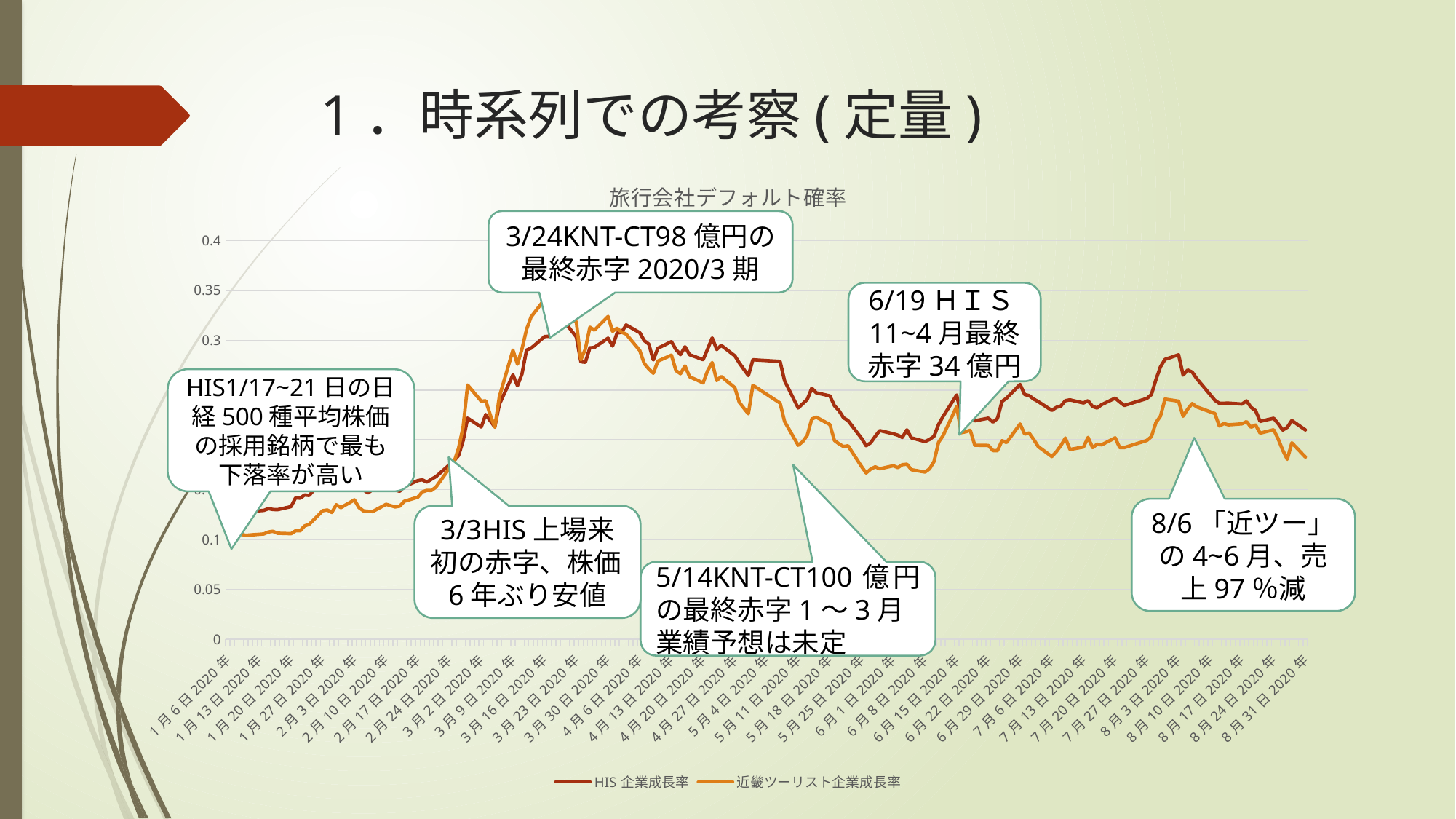
At 3月16日2020年, which series has the higher value, HIS 企業成長率 or 近畿ツーリスト企業成長率? 近畿ツーリスト企業成長率 How many dates are labelled along the x axis? 35 Which series is drawn in orange according to the legend? 近畿ツーリスト企業成長率 What kind of chart is shown on the slide? line chart Between 1月6日2020年 and 3月16日2020年, does the 近畿ツーリスト企業成長率 line generally rise or fall? rise What is the title of the chart? 旅行会社デフォルト確率 Is the value of 近畿ツーリスト企業成長率 at 3月16日2020年 greater or less than 0.3? greater Is the value of 近畿ツーリスト企業成長率 at 6月1日2020年 greater or less than 0.2? less At 4月27日2020年, which series has the higher value, HIS 企業成長率 or 近畿ツーリスト企業成長率? HIS 企業成長率 Is the value of HIS 企業成長率 at 1月6日2020年 greater or less than 0.1? greater How many series does the legend list? 2